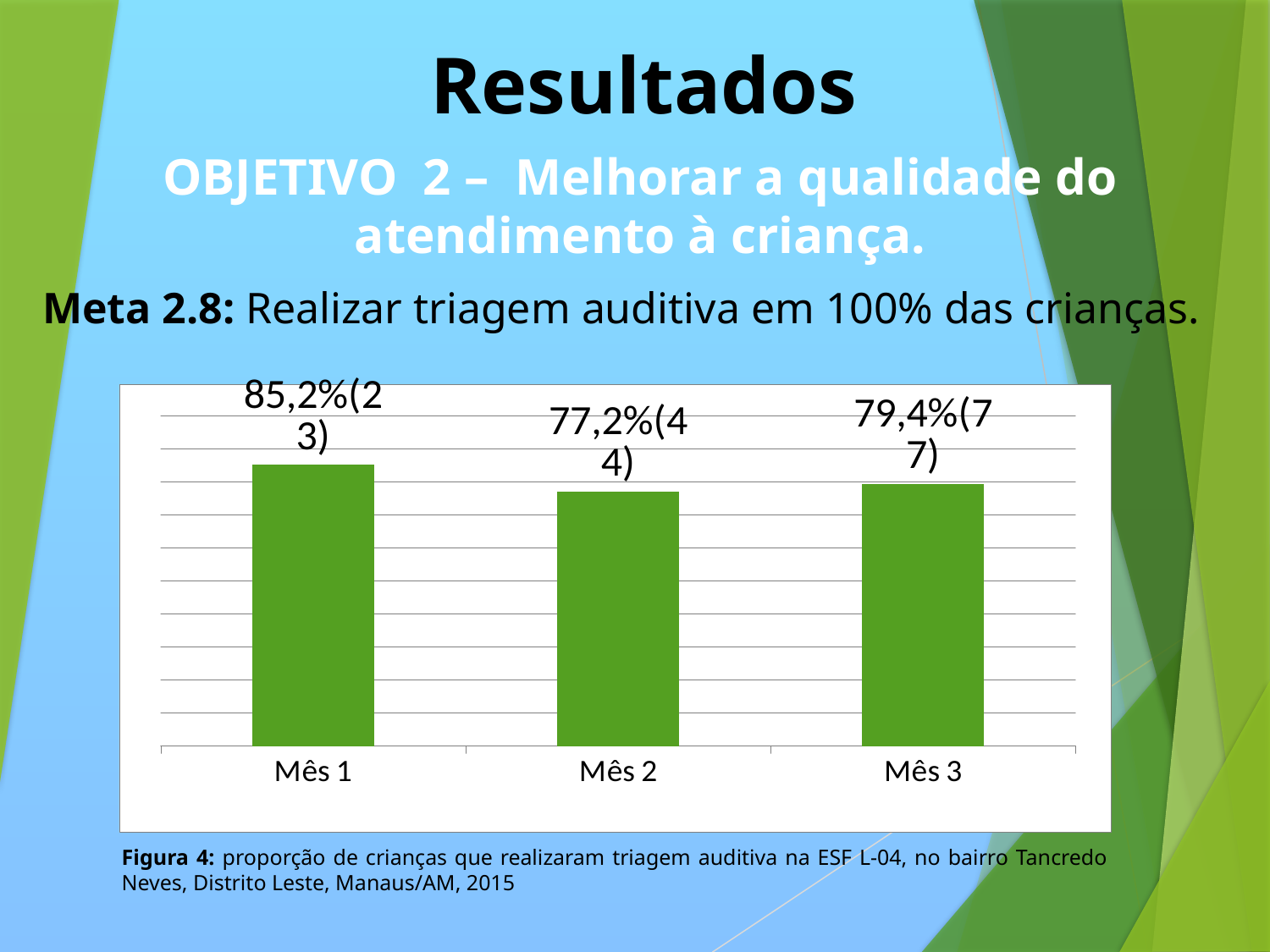
How many months (categories) are shown in the chart? 3 Which month has the lowest percentage? Mês 2 What percentage is shown for Mês 2? 77,2% What percentage is shown for Mês 3? 79,4% What number appears in parentheses next to the percentage for Mês 3? 77 What is the difference in percentage points between Mês 3 and Mês 2? 2,2 What kind of chart is shown on the slide? Bar chart Does the percentage rise or fall from Mês 1 to Mês 2? Fall Which month has the highest percentage? Mês 1 What is the difference in percentage points between Mês 1 and Mês 2? 8,0 What is the value shown for Mês 1? 85,2%(23) Which is larger, the percentage for Mês 1 or for Mês 3? Mês 1